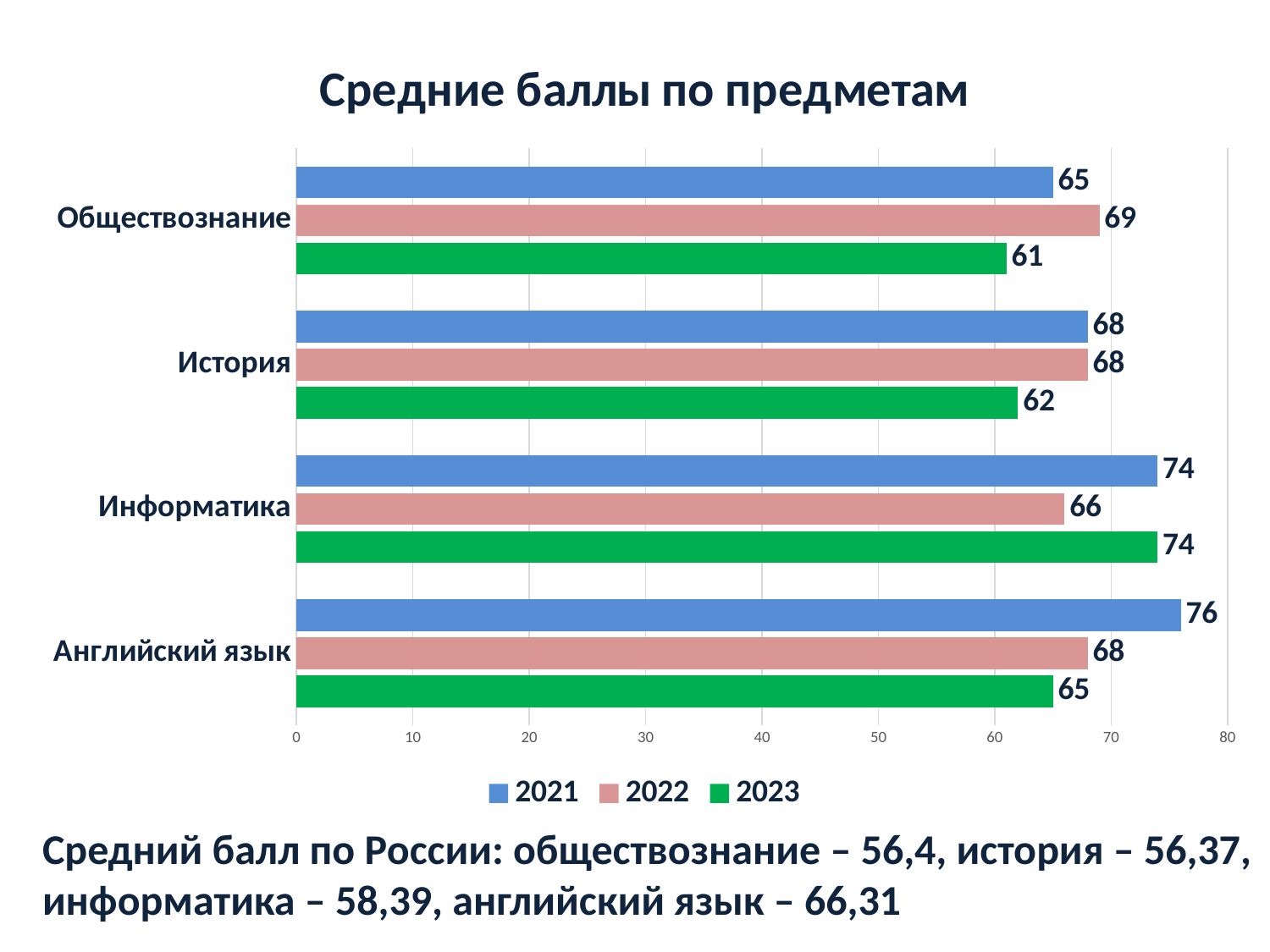
What is the difference between the 2021 and 2023 values for Английский язык? 11 What is the 2023 value for История? 62 Which colour represents the 2023 series in the legend? green How many series does the legend list? 3 Which category has the lowest 2023 value? Обществознание What is the 2021 value for Английский язык? 76 How many categories are shown on the chart? 4 What is the title of the chart? Средние баллы по предметам Which category has the highest 2021 value? Английский язык What kind of chart is shown on the slide? bar chart What is the 2022 value for Обществознание? 69 Which is larger for Информатика: the 2021 value or the 2022 value? 2021